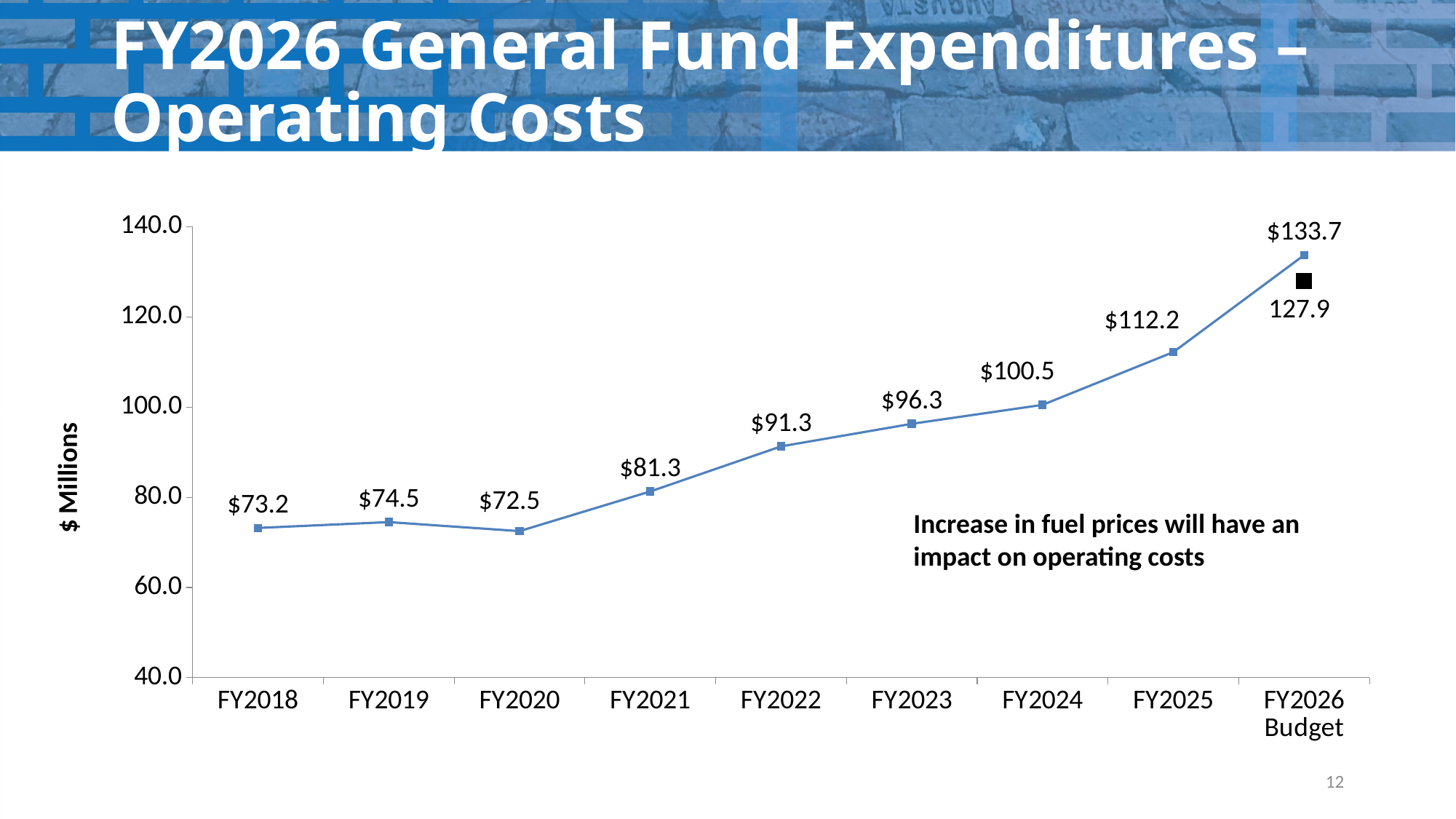
What is the difference between the FY2024 value and the FY2023 value? $4.2 What is the label of the y axis? $ Millions Which fiscal year has the highest value on the line? FY2026 Budget Do the values generally rise or fall from FY2020 to FY2026 Budget? Rise What is the value for FY2025? $112.2 What kind of chart is shown on the slide? Line chart What is the difference between the FY2026 Budget value and the FY2025 value? $21.5 Which fiscal year has the lowest value on the line? FY2020 How many fiscal years are plotted on the x axis? 9 Which is larger, the value for FY2019 or the value for FY2020? FY2019 What is the value for FY2018? $73.2 What is the value for FY2021? $81.3